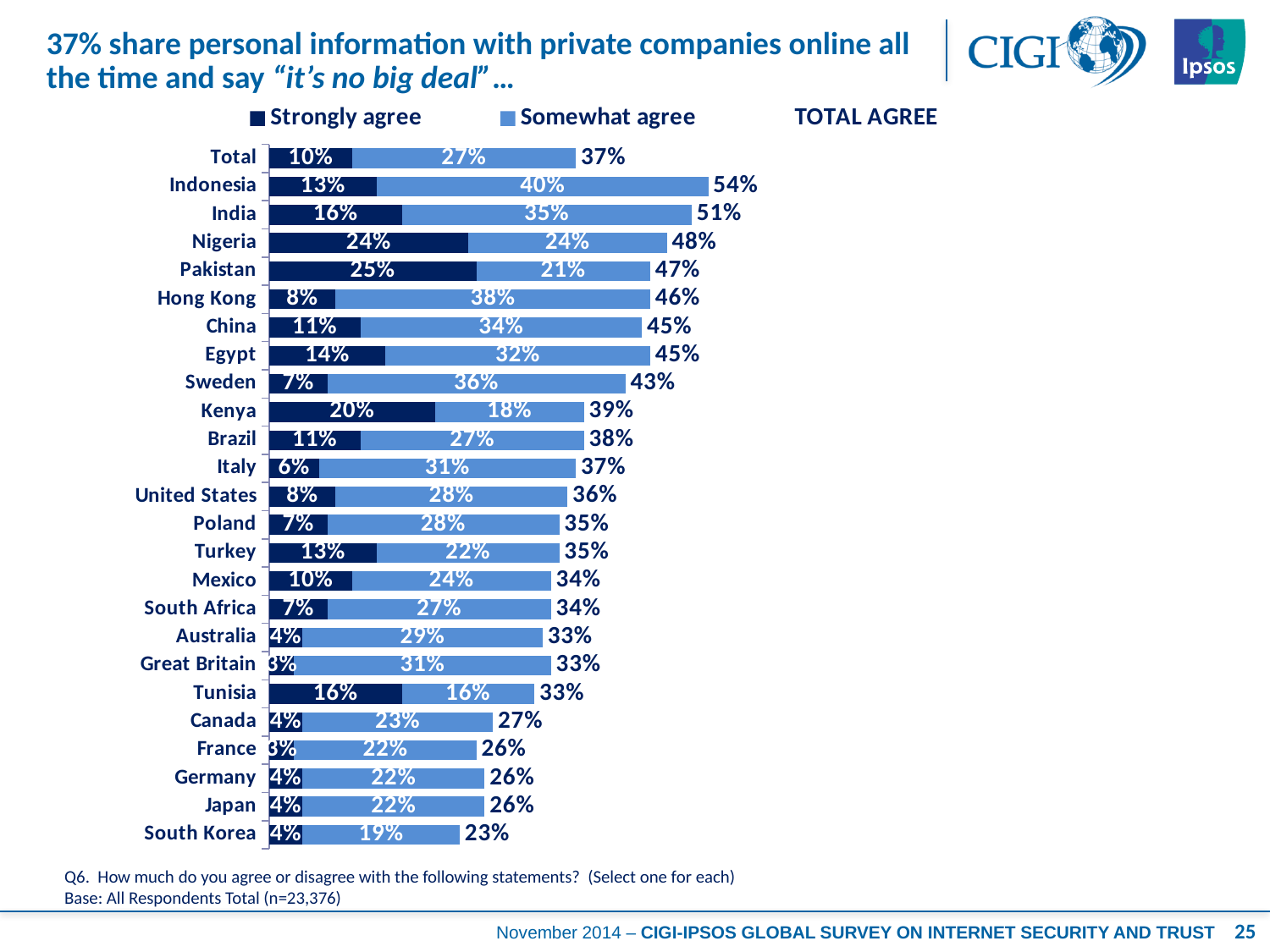
Which country has the highest total agree value? Indonesia How many categories (including Total) are shown on the chart? 25 Which country has the lowest total agree value? South Korea Which has a larger 'Somewhat agree' value, Hong Kong or Kenya? Hong Kong How many series does the legend list? 2 Which country has the highest 'Strongly agree' value? Pakistan What is the total of the stacked bar for Egypt? 45% What kind of chart is shown on the slide? Stacked bar chart What is the 'Strongly agree' value for Nigeria? 24% What is the total agree value for Sweden? 43% What is the 'Somewhat agree' value for Indonesia? 40% What is the difference between the total agree values for Indonesia and India? 3%